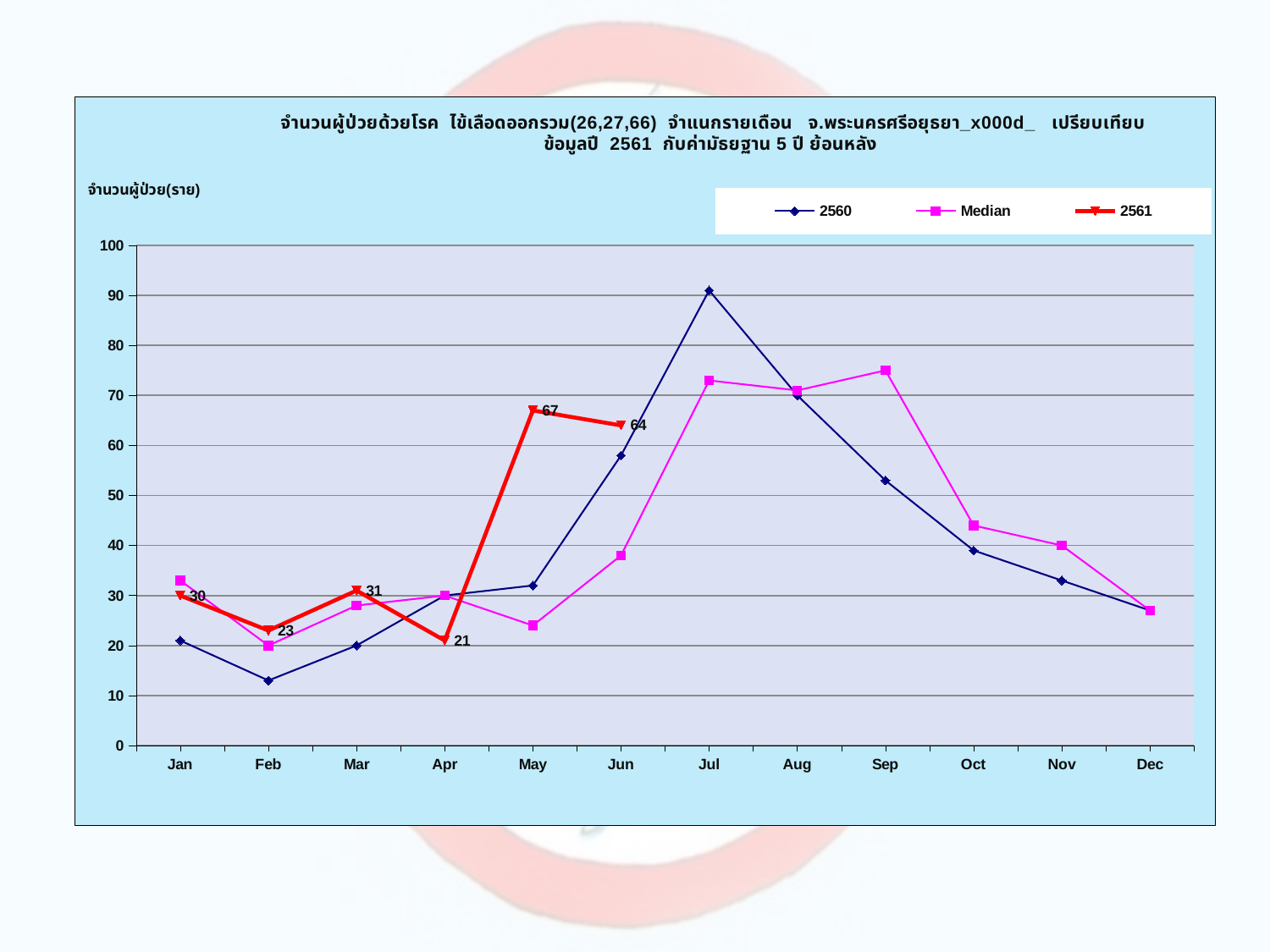
How many months are shown on the x axis? 12 How many series does the legend list? 3 Which is larger for the 2561 series, Mar or Feb? Mar In which month is the 2561 series lowest? Apr In which month is the 2561 series highest? May What is the value for 2561 in Jun? 64 What is the value for 2561 in Apr? 21 What is the value for 2561 in May? 67 Is the value for 2560 in Feb greater or less than 20? less What kind of chart is this? line chart What is the difference between the 2561 values for May and Jun? 3 Is the value for 2560 in Jul greater or less than 80? greater